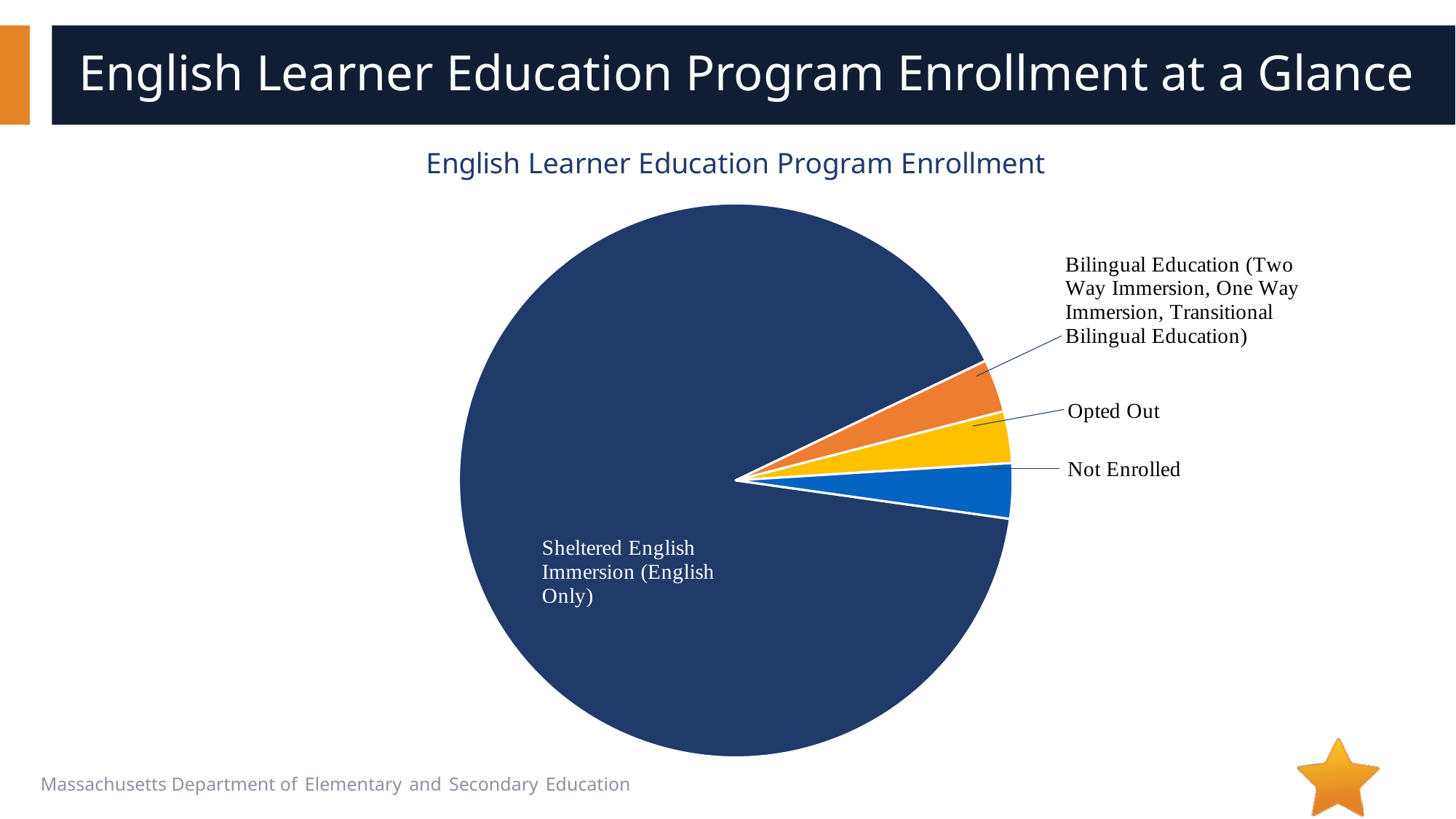
Which is larger, the slice for Sheltered English Immersion (English Only) or the slice for Not Enrolled? Sheltered English Immersion (English Only) Which category has the largest share of the pie? Sheltered English Immersion (English Only) How many slices does the pie chart have? 4 What kind of chart is shown on the slide? pie chart What colour is the Opted Out slice? yellow Which is larger, the slice for Opted Out or the slice for Sheltered English Immersion (English Only)? Sheltered English Immersion (English Only) What is the title of the chart? English Learner Education Program Enrollment Does the Sheltered English Immersion (English Only) slice make up more or less than half of the pie? more